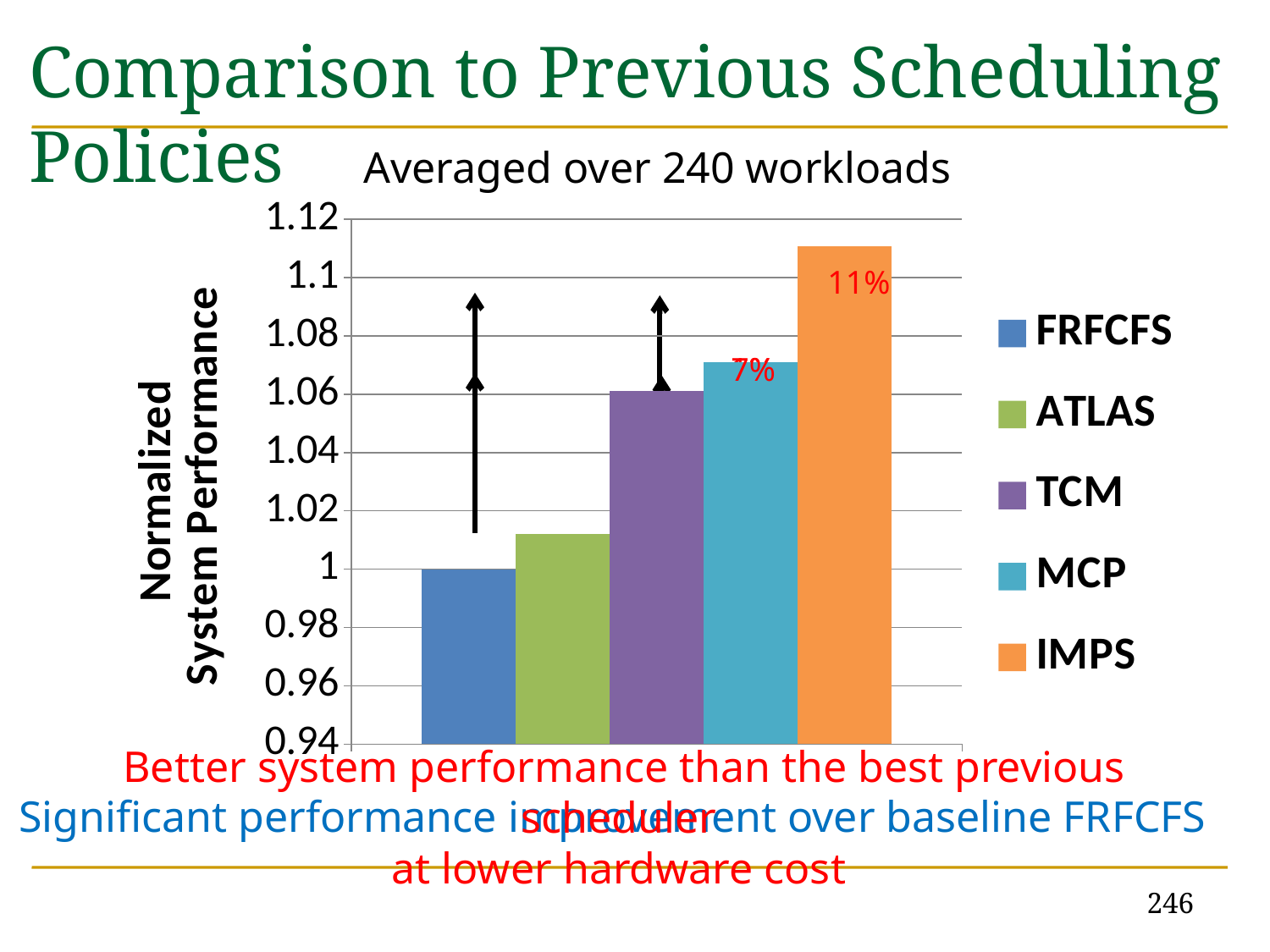
What kind of chart is shown on the slide? bar chart Do the bar values rise or fall from left to right across the chart? rise Is the value for ATLAS greater or less than 1.02? less Which scheduling policy has the highest normalized system performance? IMPS Which scheduling policy has the lowest normalized system performance? FRFCFS What is the label on the vertical axis of the chart? Normalized System Performance How many series does the legend list? 5 Is the value for TCM greater or less than 1.04? greater Which has a higher normalized system performance, MCP or IMPS? IMPS What is the normalized system performance of FRFCFS? 1 Is the value for IMPS greater or less than 1.1? greater Which has a higher normalized system performance, TCM or ATLAS? TCM